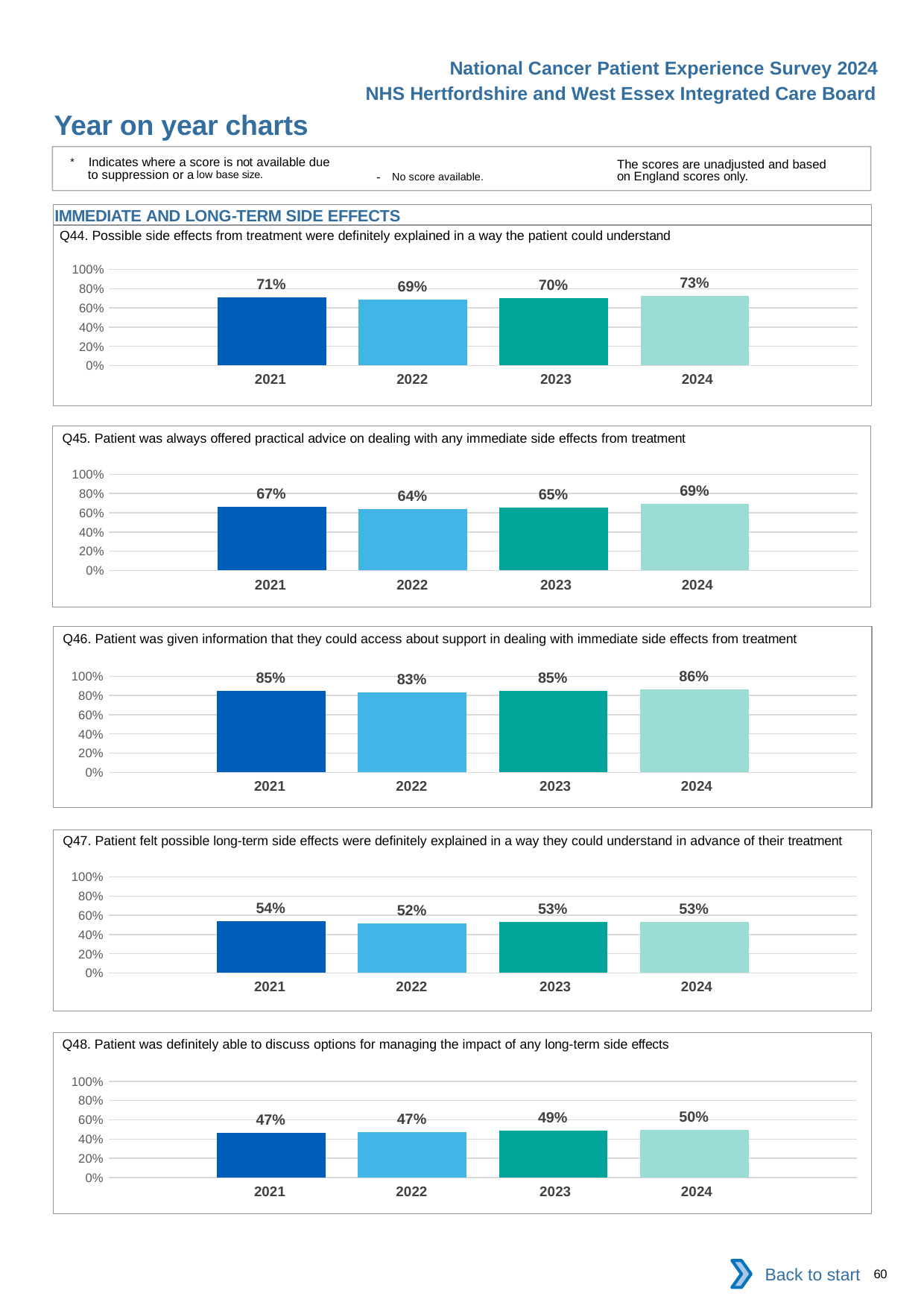
What kind of chart is the Q46 chart? bar chart In the Q45 chart, how many years are plotted? 4 In the Q48 chart, is the value for 2024 greater or less than 40%? greater In the Q44 chart, what is the value for 2024? 73% In the Q46 chart, what is the difference between the 2024 and 2022 values? 3% In the Q47 chart, which year has the highest value? 2021 In the Q47 chart, what is the difference between the 2021 and 2022 values? 2% In the Q45 chart, what is the value for 2021? 67% In the Q45 chart, which year has the lowest value? 2022 What is the section heading above the Q44 chart? IMMEDIATE AND LONG-TERM SIDE EFFECTS In the Q48 chart, what is the value for 2023? 49% In the Q44 chart, is the value for 2021 larger or smaller than the value for 2022? larger